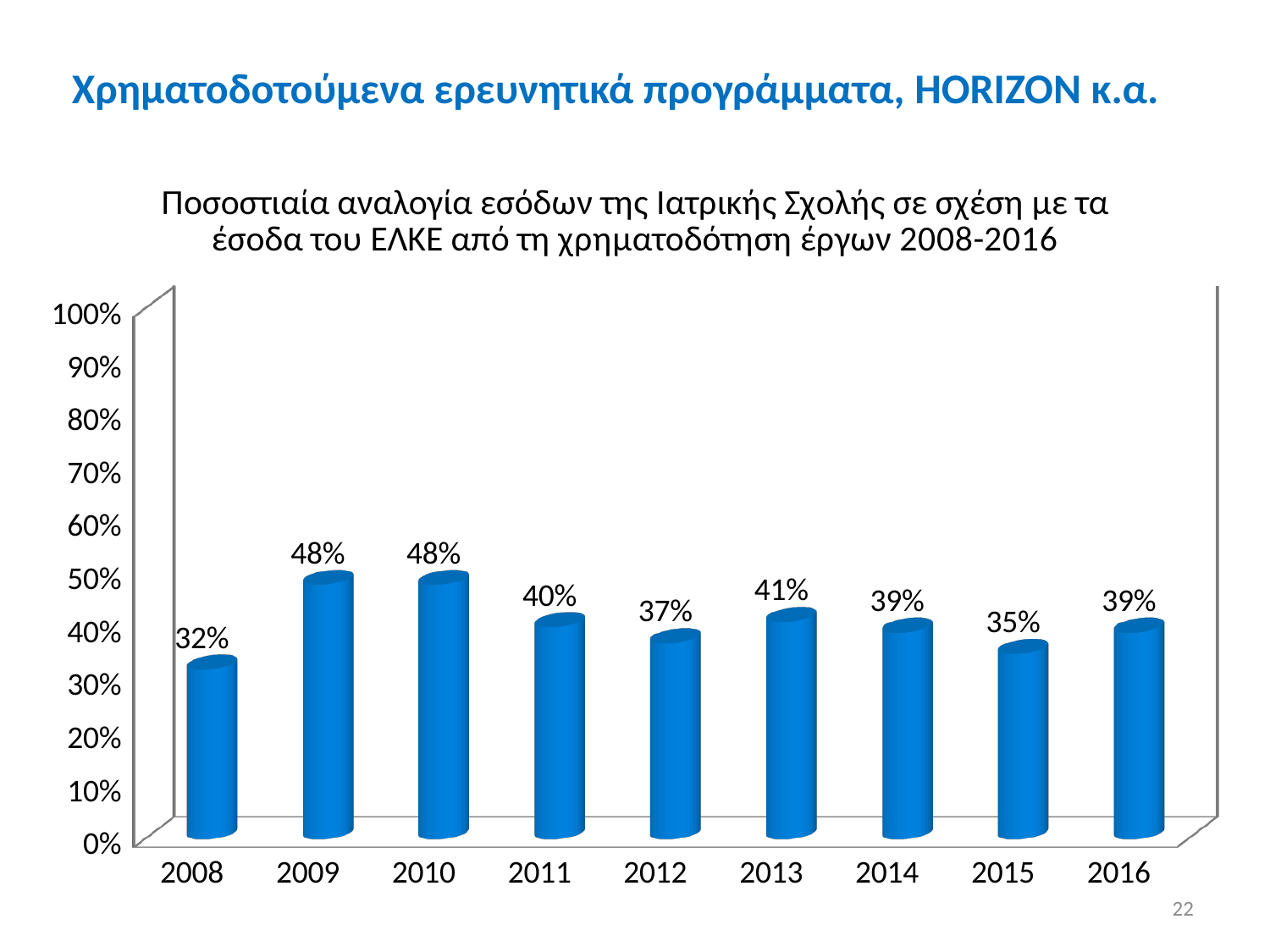
How many years are shown on the x axis? 9 What is the highest value shown on the vertical axis? 100% What is the difference between the values for 2009 and 2008? 16% Is the value for 2010 greater or less than 40%? greater What is the value for 2013? 41% What is the difference between the values for 2011 and 2012? 3% What kind of chart is shown on the slide? bar chart What is the value for 2008? 32% What is the value for 2015? 35% Which is larger, the value for 2013 or the value for 2015? 2013 Do the values rise or fall from 2013 to 2015? fall Which year has the lowest value? 2008